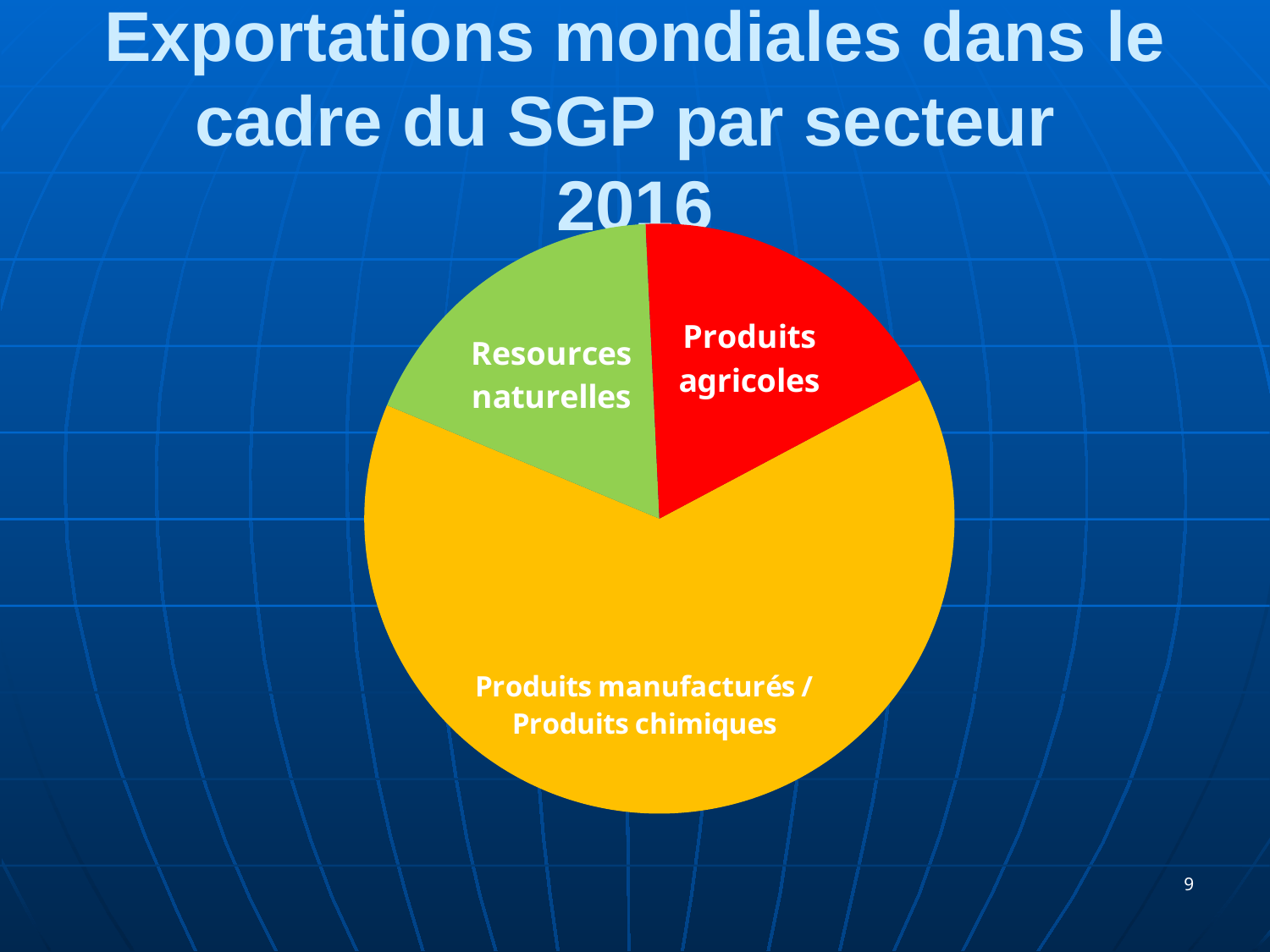
How many slices does the pie chart have? 3 Is the slice for Resources naturelles larger or smaller than the slice for Produits manufacturés / Produits chimiques? smaller What is the title of the slide containing the pie chart? Exportations mondiales dans le cadre du SGP par secteur 2016 What colour is the slice for Produits agricoles? red What kind of chart is shown on the slide? pie chart Does the Produits manufacturés / Produits chimiques slice account for more or less than half of the pie? more Which sector has the largest slice of the pie chart? Produits manufacturés / Produits chimiques Is the slice for Produits manufacturés / Produits chimiques larger or smaller than the slice for Produits agricoles? larger